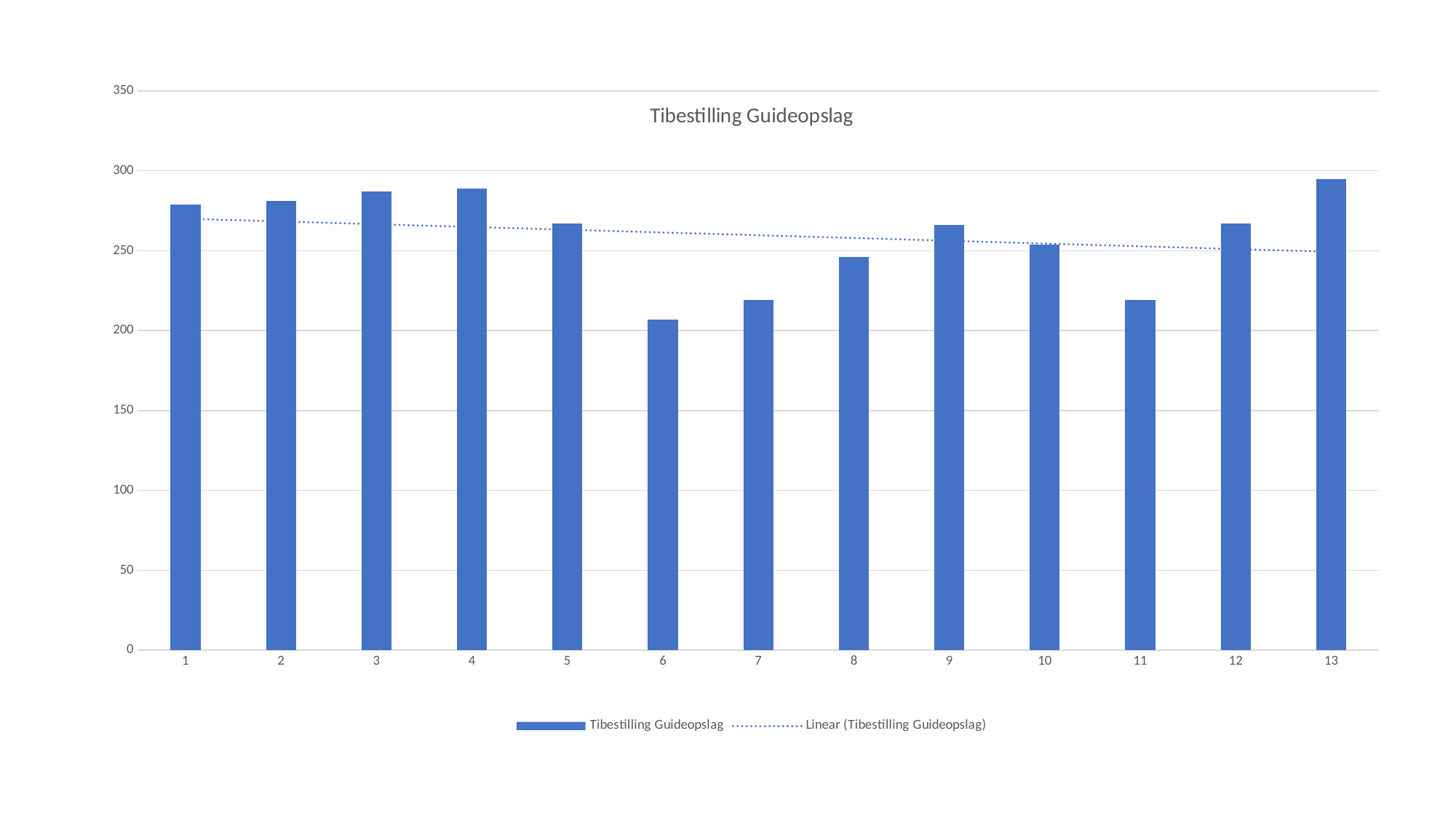
Is the value for category 7 greater or less than 250? less How many entries does the legend list? 2 What kind of chart is shown on the slide? bar chart Is the value for category 3 greater or less than 250? greater Is the value for category 13 greater or less than 250? greater Which is larger, the value for category 1 or the value for category 5? category 1 What is the title of the chart? Tibestilling Guideopslag How many categories are shown on the x axis? 13 Which category has the lowest bar? 6 Does the dotted linear trendline rise or fall from left to right? fall Which category has the highest bar? 13